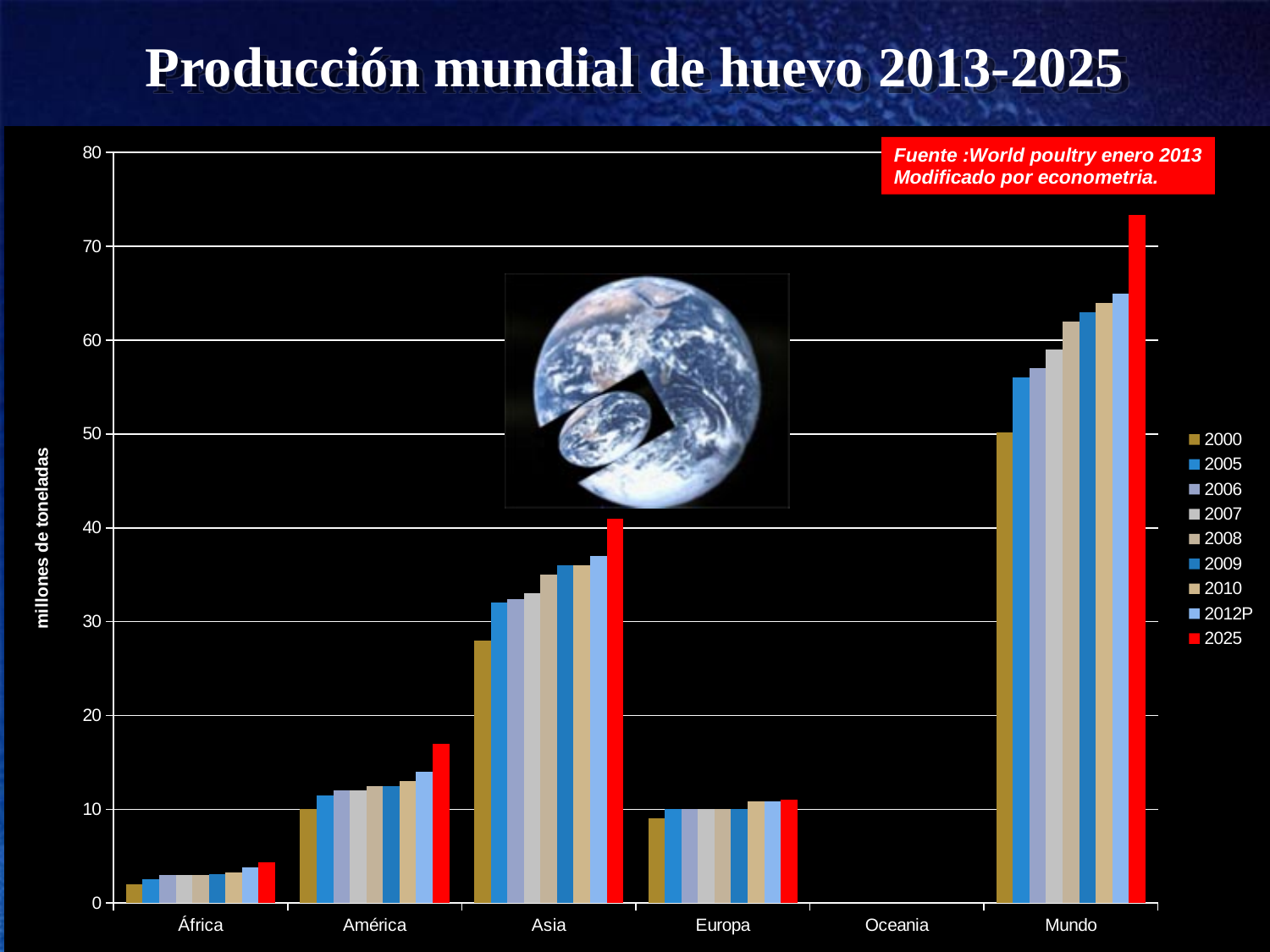
How many categories are shown on the x axis of the chart? 6 Which category has the highest bars in the chart? Mundo Which category has the lowest values in the chart? África Do the values for Asia rise or fall from 2000 to 2025? rise Is the value for África in 2025 greater or less than 10? less What is the label of the vertical axis? millones de toneladas Is the value for Asia in 2000 greater or less than 30? less What kind of chart is shown on the slide? bar chart How many series does the legend list? 9 Which is larger in 2025, the value for Asia or the value for América? Asia Is the value for Mundo in 2025 greater or less than 70? greater